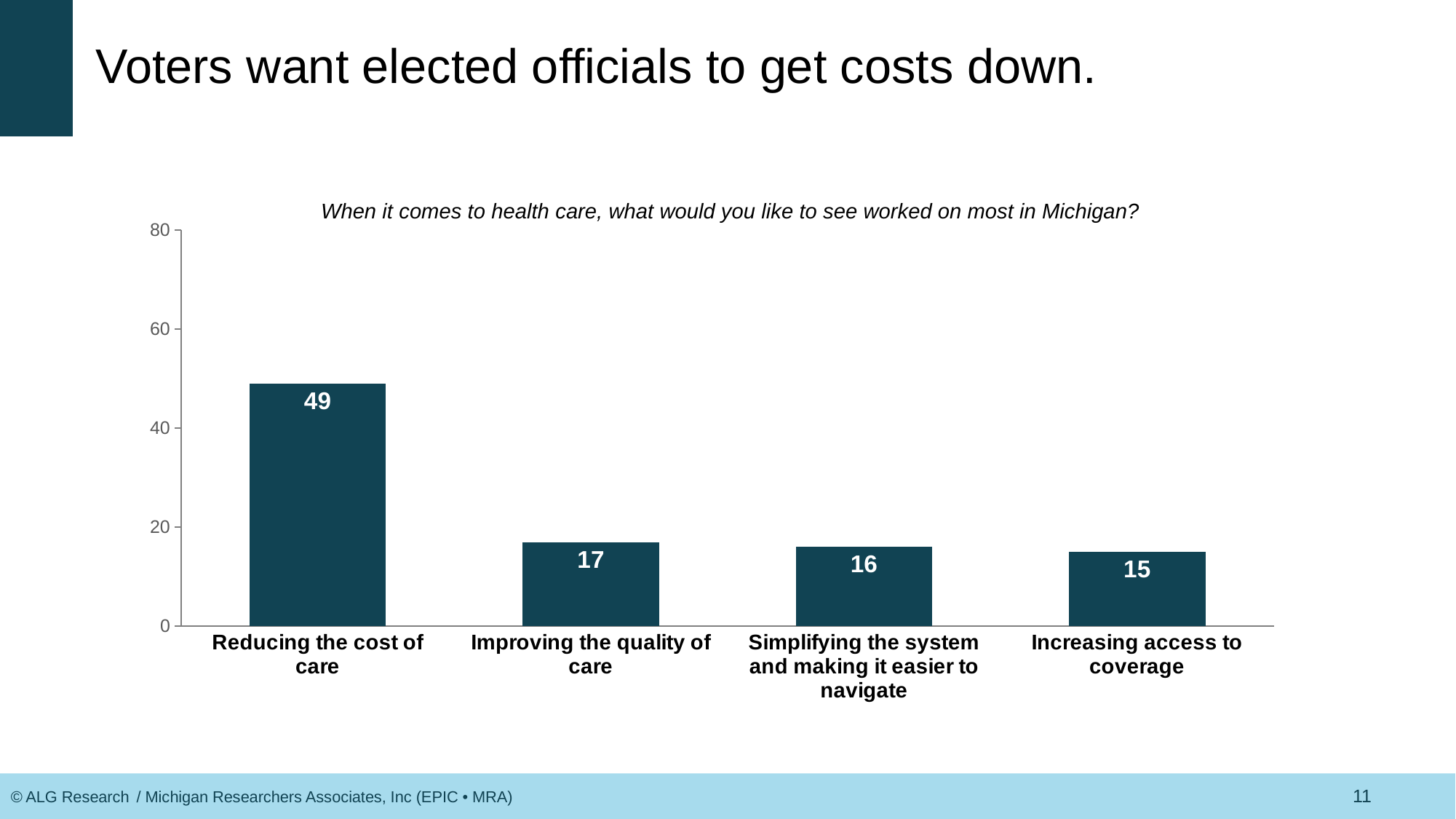
What is the value for "Reducing the cost of care"? 49 Is the value for "Reducing the cost of care" greater or less than 40? greater What kind of chart is shown on the slide? Bar chart Which category has the lowest value? Increasing access to coverage What is the difference between the values for "Reducing the cost of care" and "Improving the quality of care"? 32 What is the value for "Simplifying the system and making it easier to navigate"? 16 What is the value for "Increasing access to coverage"? 15 Which is larger, the value for "Improving the quality of care" or the value for "Increasing access to coverage"? Improving the quality of care Which category has the highest value? Reducing the cost of care What is the value for "Improving the quality of care"? 17 How many categories are shown in the chart? 4 What question is shown as the chart's title? When it comes to health care, what would you like to see worked on most in Michigan?